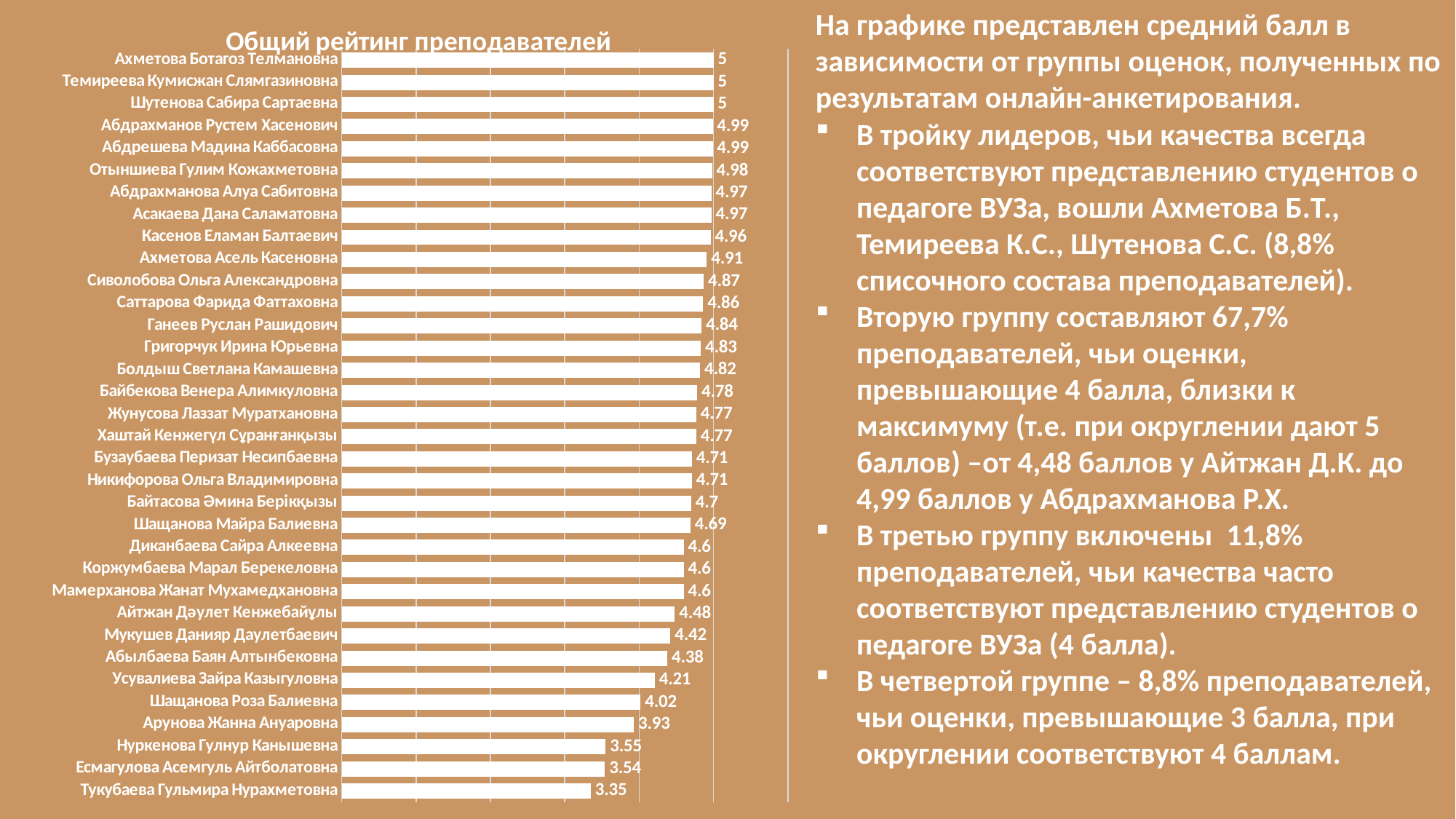
Which is larger, the value for Нуркенова Гулнур Канышевна or the value for Абылбаева Баян Алтынбековна? Абылбаева Баян Алтынбековна What is the value for Арунова Жанна Ануаровна? 3.93 What is the difference between the values for Ахметова Ботагоз Телмановна and Тукубаева Гульмира Нурахметовна? 1.65 Which teacher has the lowest rating in the chart? Тукубаева Гульмира Нурахметовна What is the title of the chart? Общий рейтинг преподавателей How many teachers are listed in the chart? 34 What is the difference between the values for Шащанова Майра Балиевна and Шащанова Роза Балиевна? 0.67 What type of chart is shown on the slide? bar chart Which is larger, the value for Мукушев Данияр Даулетбаевич or the value for Усувалиева Зайра Казыгуловна? Мукушев Данияр Даулетбаевич What is the value for Айтжан Дәулет Кенжебайұлы? 4.48 What is the value for Касенов Еламан Балтаевич? 4.96 Do the values rise or fall going down the chart from top to bottom? fall